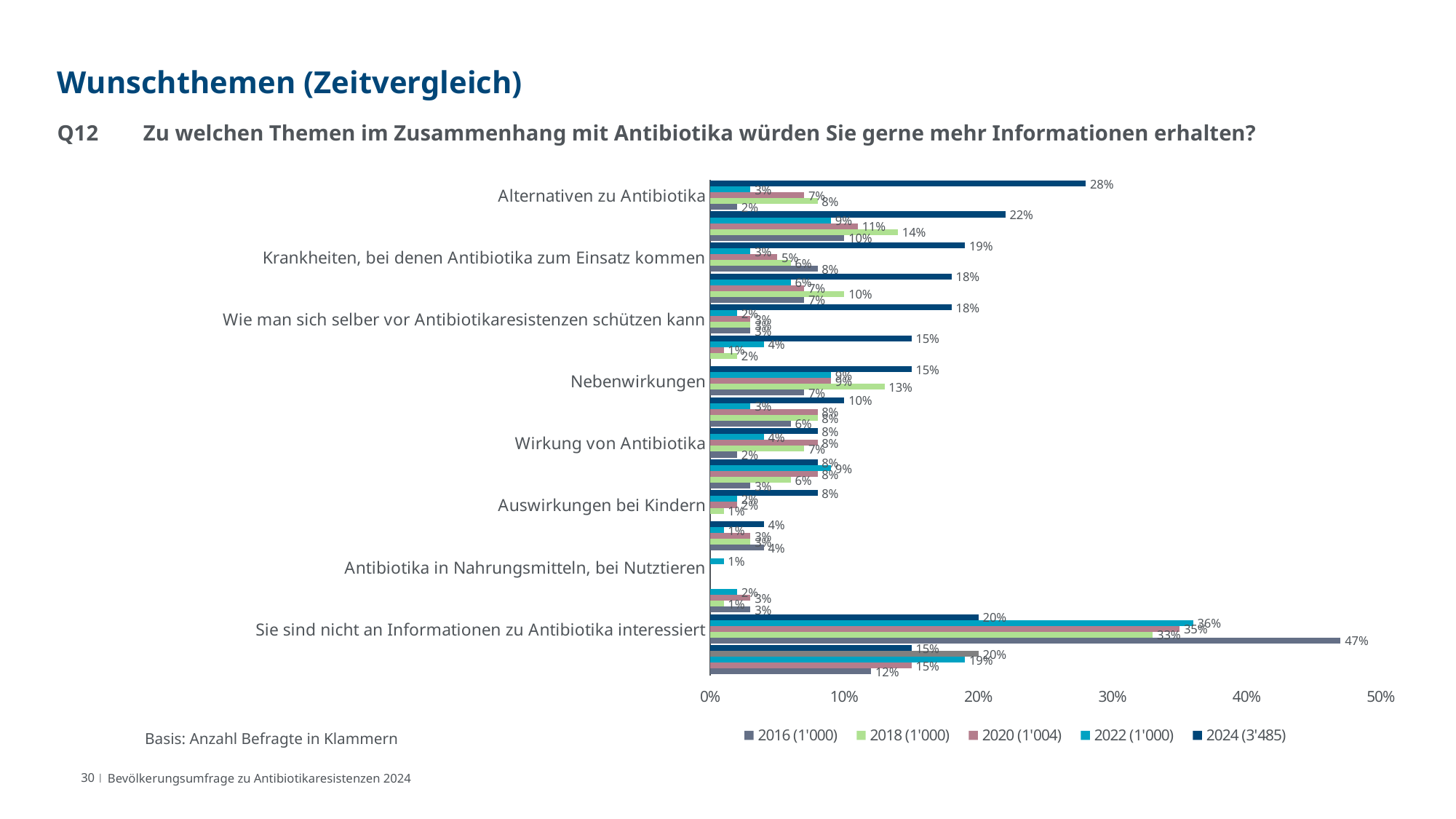
What is the 2024 value for "Krankheiten, bei denen Antibiotika zum Einsatz kommen"? 19% What is the difference between the 2016 and 2024 values for "Sie sind nicht an Informationen zu Antibiotika interessiert"? 27 percentage points What is the 2016 value for "Sie sind nicht an Informationen zu Antibiotika interessiert"? 47% Which year has the lowest value for "Sie sind nicht an Informationen zu Antibiotika interessiert"? 2024 How many series does the legend list? 5 Which year has the highest value for "Sie sind nicht an Informationen zu Antibiotika interessiert"? 2016 What is the 2022 value for "Antibiotika in Nahrungsmitteln, bei Nutztieren"? 1% What kind of chart is shown on the slide? bar chart What is the 2018 value for "Nebenwirkungen"? 13% Which is larger in 2024: "Alternativen zu Antibiotika" or "Nebenwirkungen"? Alternativen zu Antibiotika What is the 2024 value for "Alternativen zu Antibiotika"? 28% According to the legend, how many respondents were surveyed in 2024? 3'485